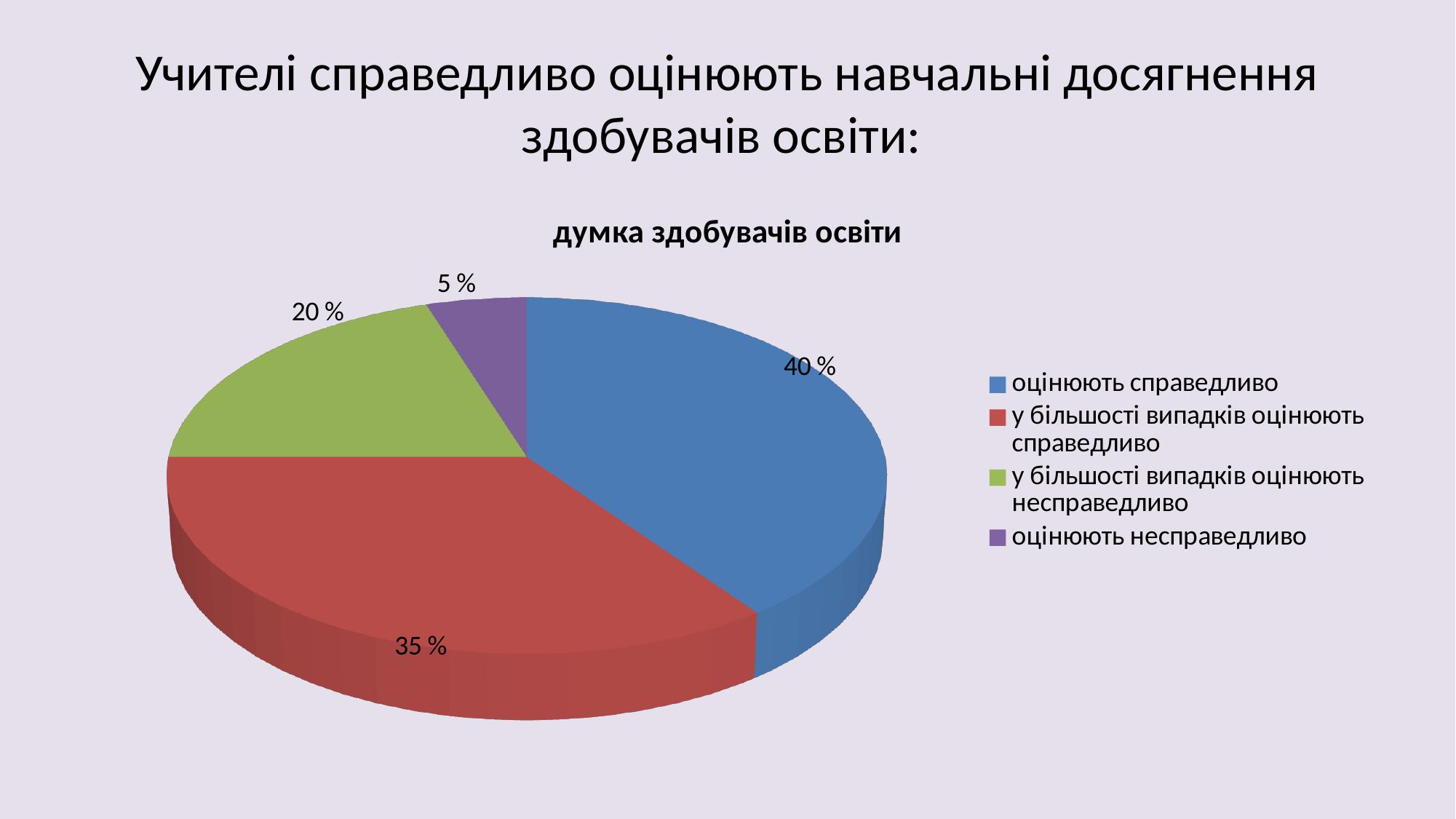
What share of the pie is labelled for "у більшості випадків оцінюють справедливо"? 35 % How many categories does the legend list? 4 What share of the pie is labelled for "оцінюють справедливо"? 40 % Which category has the largest slice of the pie? оцінюють справедливо Which is larger: the share for "у більшості випадків оцінюють несправедливо" or the share for "оцінюють несправедливо"? у більшості випадків оцінюють несправедливо What kind of chart is shown on the slide? pie chart What is the difference between the shares for "оцінюють справедливо" and "у більшості випадків оцінюють справедливо"? 5 % Which category has the smallest slice of the pie? оцінюють несправедливо What colour is the slice for "у більшості випадків оцінюють несправедливо"? green What is the title of the chart? думка здобувачів освіти What share of the pie is labelled for "у більшості випадків оцінюють несправедливо"? 20 % What share of the pie is labelled for "оцінюють несправедливо"? 5 %